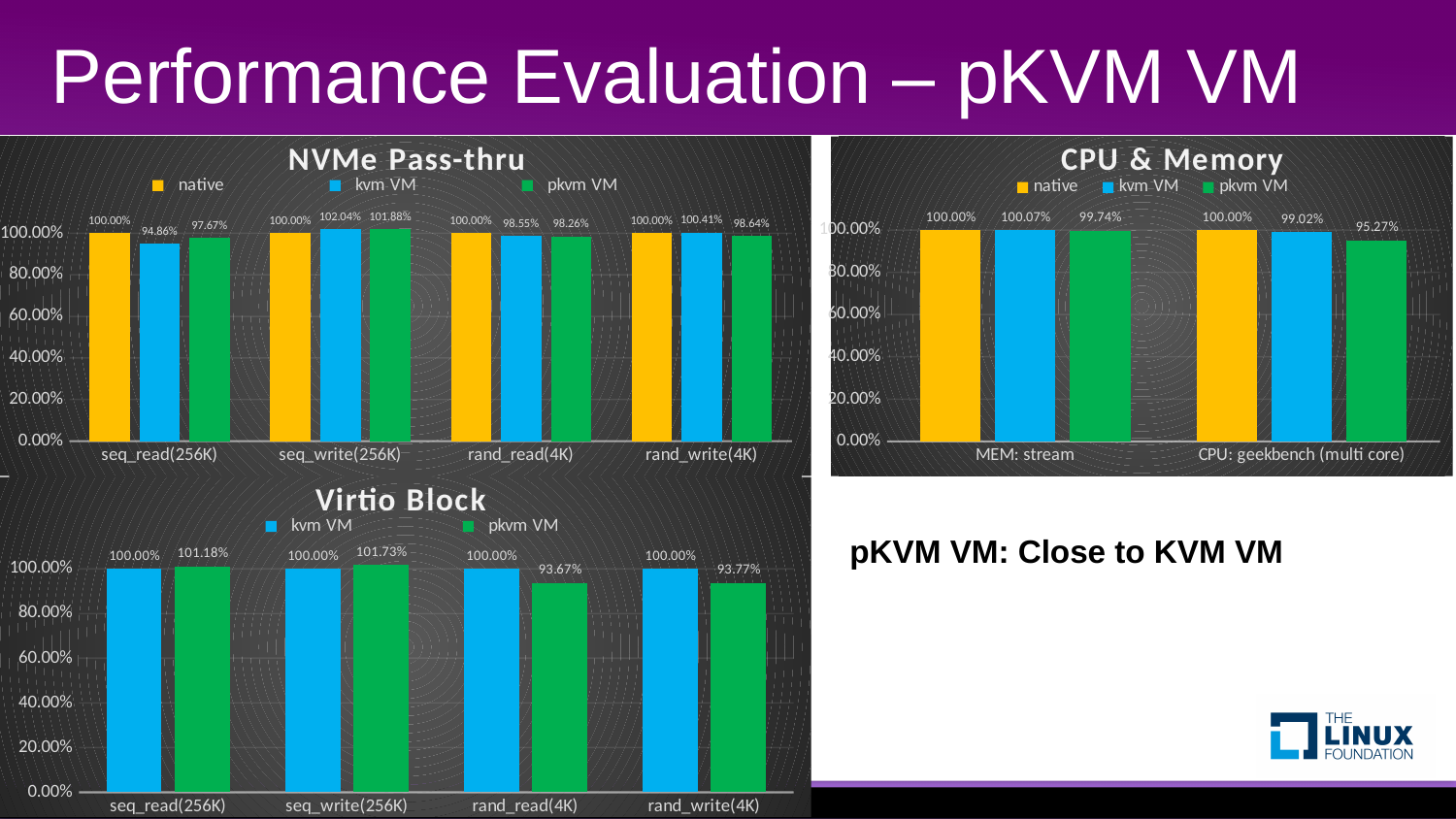
In the NVMe Pass-thru chart, what is the difference between the kvm VM and pkvm VM values at rand_write(4K)? 1.77% In the Virtio Block chart, how many categories are shown on the x axis? 4 In the Virtio Block chart, which category has the highest pkvm VM value? seq_write(256K) In the NVMe Pass-thru chart, what is the value for kvm VM at seq_read(256K)? 94.86% In the NVMe Pass-thru chart, how many series does the legend list? 3 In the CPU & Memory chart, what is the difference between the native and pkvm VM values at CPU: geekbench (multi core)? 4.73% In the CPU & Memory chart, which is larger at MEM: stream, the kvm VM value or the pkvm VM value? kvm VM In the Virtio Block chart, what is the value for pkvm VM at rand_read(4K)? 93.67% In the NVMe Pass-thru chart, what is the value for pkvm VM at seq_write(256K)? 101.88% What kind of chart is the CPU & Memory chart? Bar chart In the CPU & Memory chart, what is the value for pkvm VM at CPU: geekbench (multi core)? 95.27% In the Virtio Block chart, which series does the legend list besides pkvm VM? kvm VM